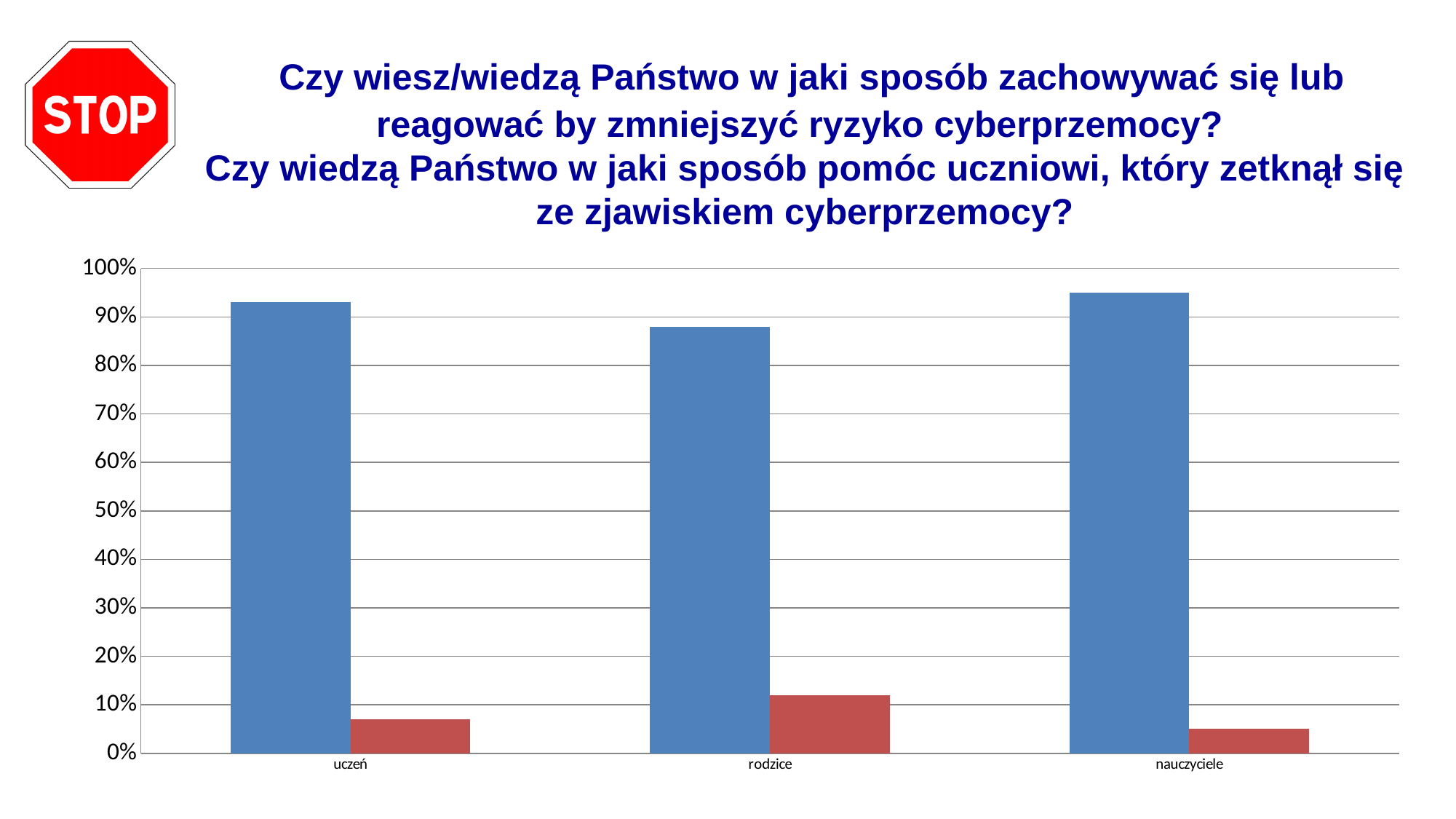
Is the blue bar for nauczyciele greater or less than 90%? greater What kind of chart is shown on the slide? bar chart Which category has the highest red bar? rodzice Is the blue bar for rodzice greater or less than 90%? less Which is larger, the blue bar for uczeń or the blue bar for rodzice? uczeń Is the red bar for rodzice greater or less than 10%? greater How many categories are shown on the x axis of the chart? 3 Which is larger, the red bar for rodzice or the red bar for nauczyciele? rodzice Which category has the lowest blue bar? rodzice What are the two colours of the bars in the chart? blue and red